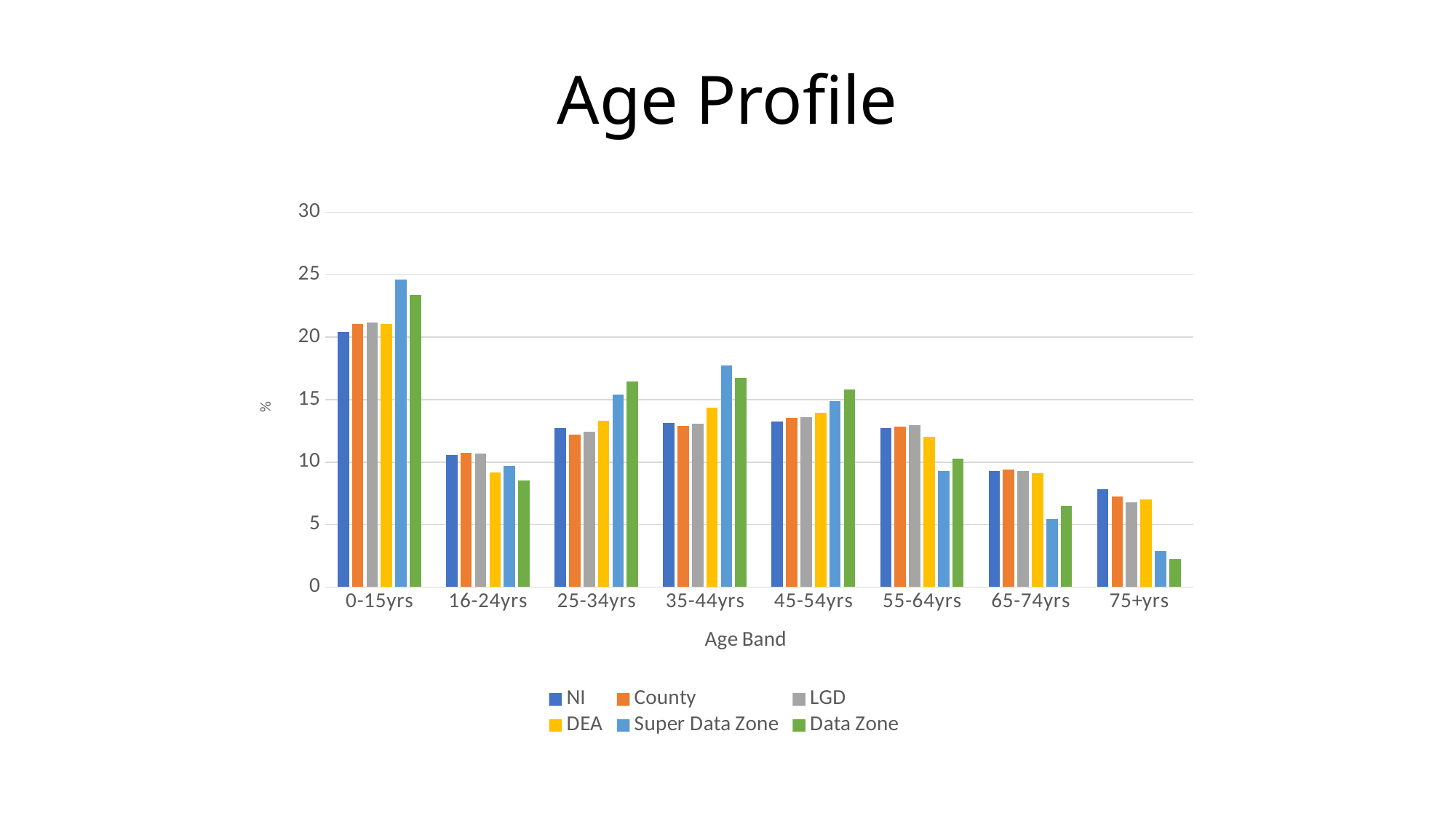
Do the Super Data Zone values rise or fall from 45-54yrs to 75+yrs? fall Is the DEA value for 16-24yrs greater or less than 10? less What kind of chart is shown on the slide? Bar chart What is the title of the x axis? Age Band Which age band has the lowest Data Zone value? 75+yrs Which age band has the highest Super Data Zone value? 0-15yrs For the 65-74yrs age band, which is larger: the Data Zone value or the Super Data Zone value? Data Zone Is the Data Zone value for 75+yrs greater or less than 5? less Is the Super Data Zone value for 0-15yrs greater or less than 20? greater How many series does the legend list? 6 For the 35-44yrs age band, which is larger: the NI value or the Super Data Zone value? Super Data Zone How many age bands are shown on the x axis? 8